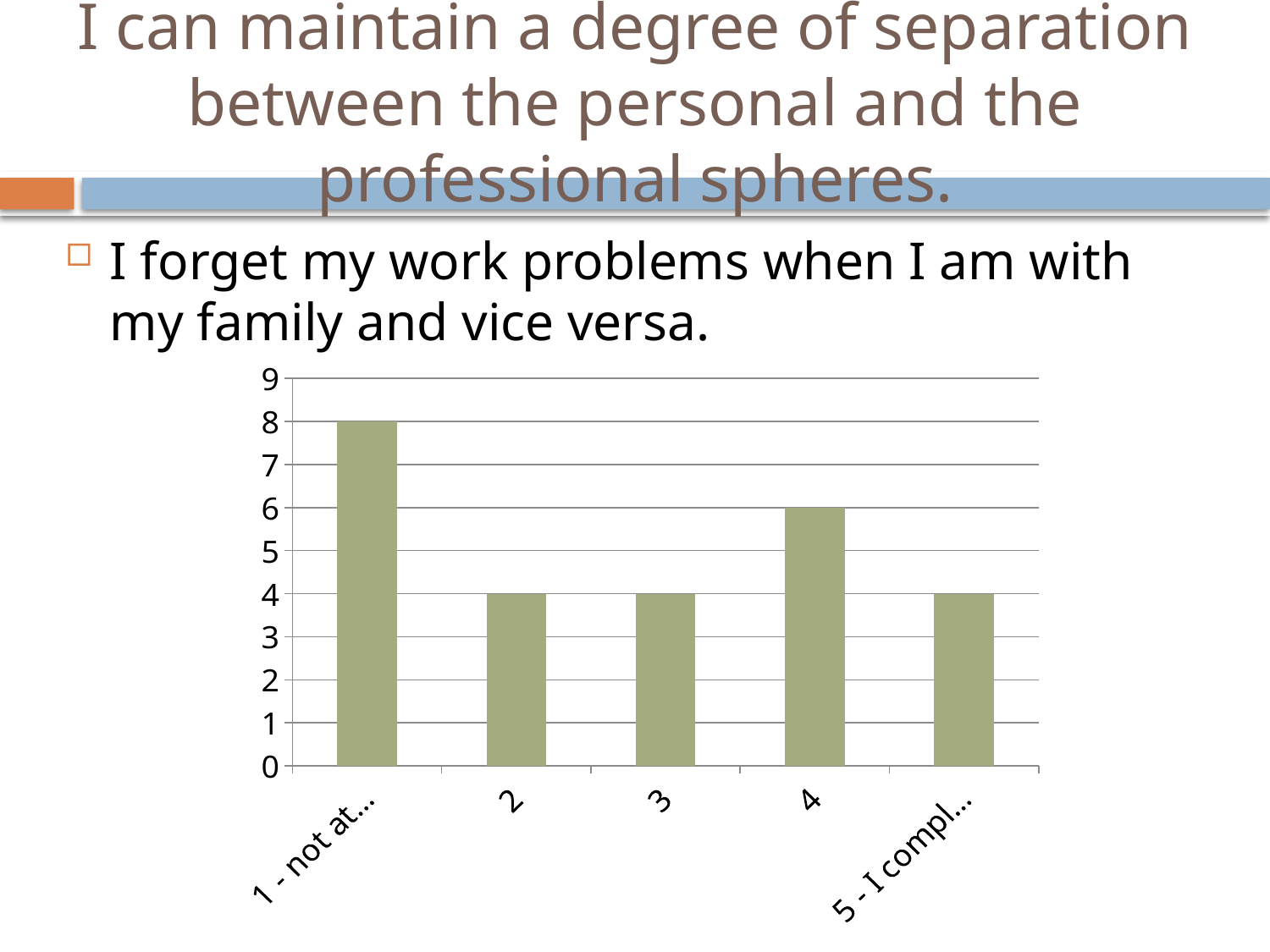
Is the value for the first category greater or less than 7? greater What kind of chart is shown on the slide? bar chart What is the value for the first category, labelled "1 - not at..."? 8 What is the value for category 2? 4 What is the difference between the values for category 1 and category 4? 2 What is the difference between the values for category 4 and category 2? 2 What is the highest value shown on the vertical axis? 9 Which is larger, the value for category 4 or the value for category 3? category 4 What is the value for category 3? 4 How many categories are shown on the x axis? 5 Which category has the highest value? 1 - not at... What is the value for category 4? 6